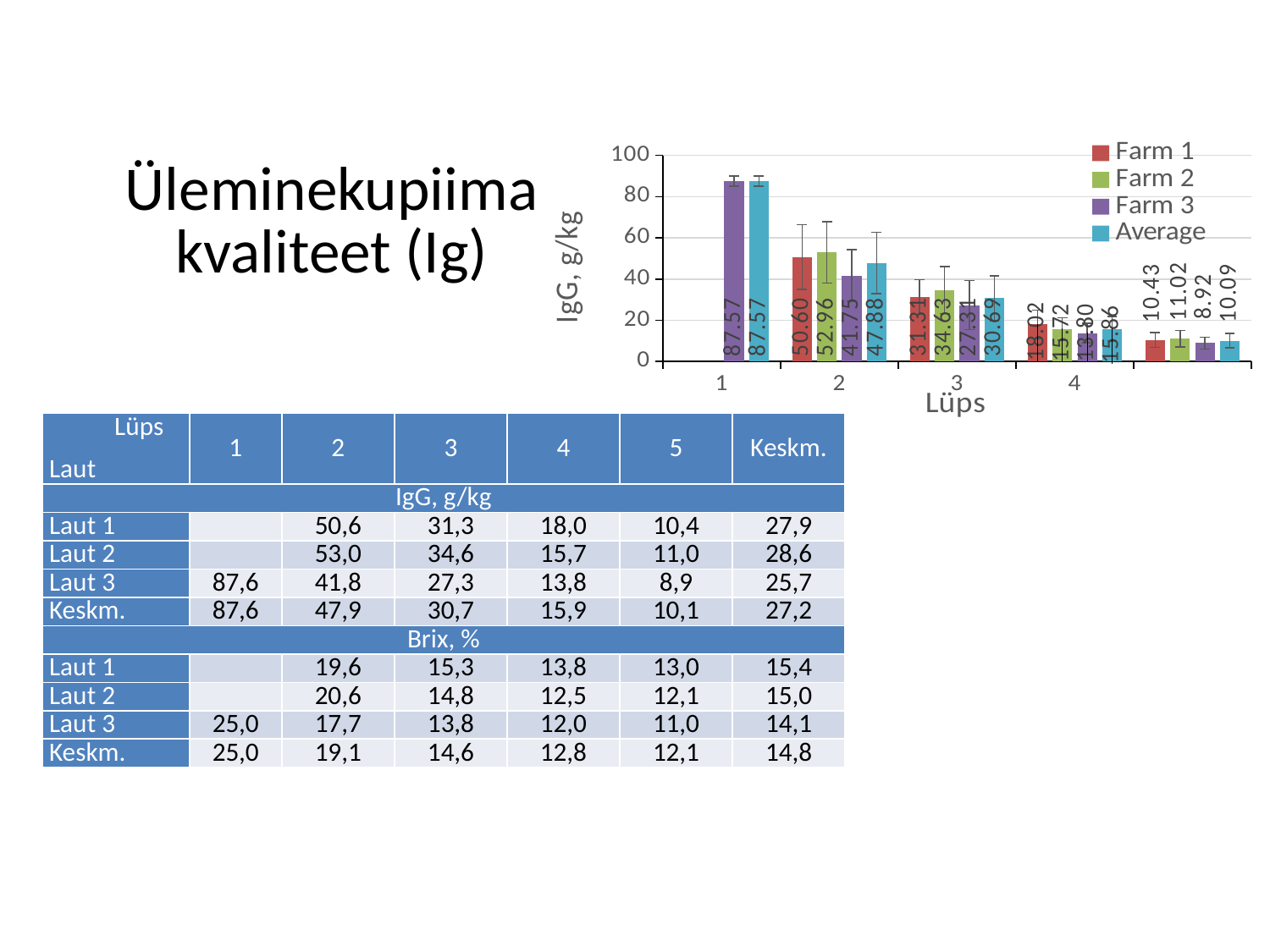
What kind of chart is shown on the slide? bar chart Which is larger for Lüps 3: the Farm 1 value or the Farm 2 value? Farm 2 What is the Farm 1 value for Lüps 2 in the chart? 50.60 Is the Farm 3 value for Lüps 2 greater or less than 60? less Which series has the highest value for Lüps 2? Farm 2 Does the Average series rise or fall as Lüps increases along the x axis? fall What is the Farm 2 value for Lüps 2 in the chart? 52.96 What is the difference between the Farm 2 and Farm 3 values for Lüps 2? 11.21 Which series has the lowest value for Lüps 3? Farm 3 What is the Average value for Lüps 1 in the chart? 87.57 How many series does the chart legend list? 4 What is the Farm 3 value for Lüps 3 in the chart? 27.31